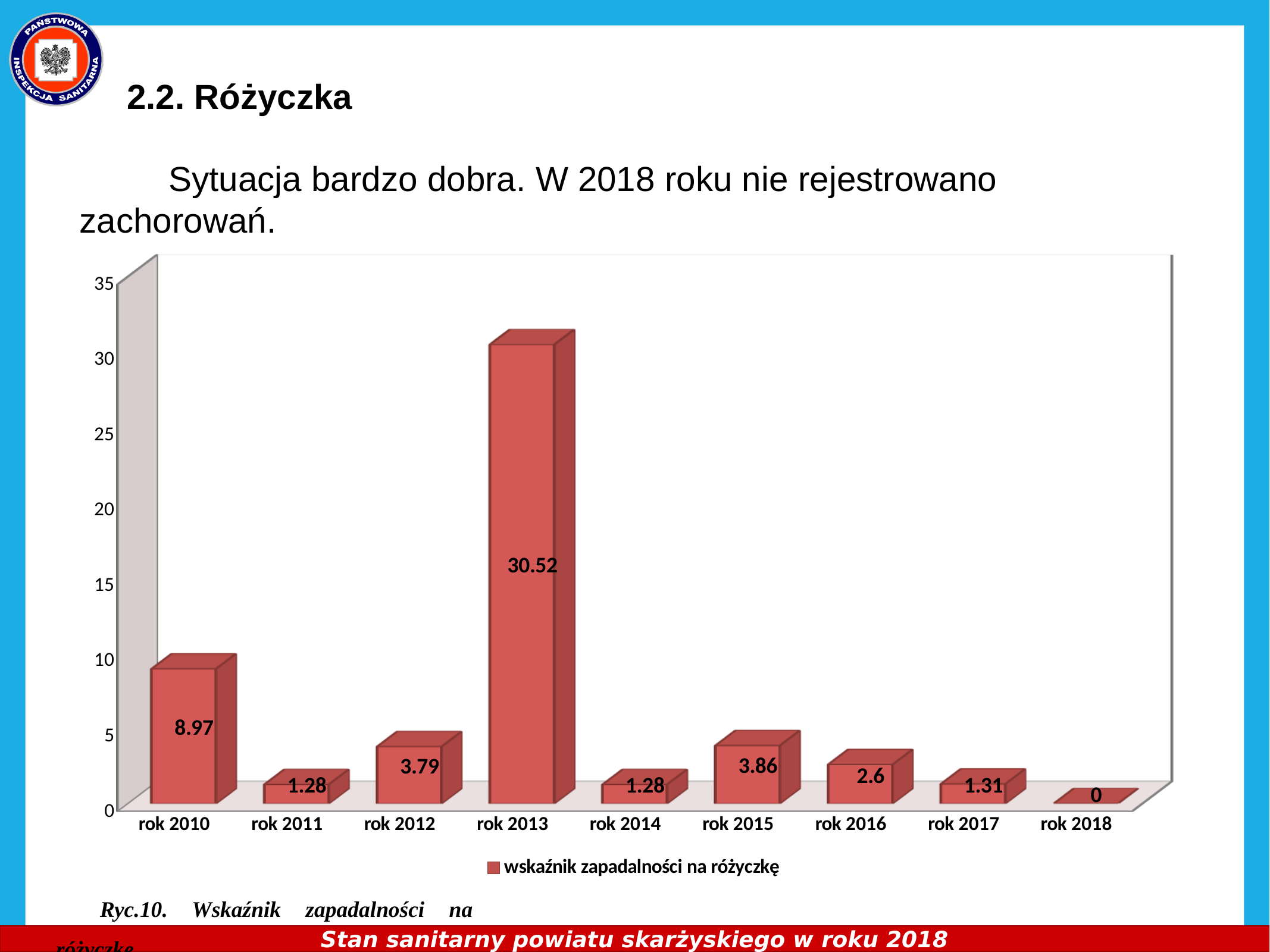
Is the value for rok 2013 greater or less than 30? greater What is the difference between the values for rok 2013 and rok 2010? 21.55 Which is larger, the value for rok 2012 or the value for rok 2015? rok 2015 What is the value for rok 2016? 2.6 Which year has the highest value? rok 2013 Which year has the lowest value? rok 2018 What is the legend entry of the series shown in the chart? wskaźnik zapadalności na różyczkę What is the value for rok 2018? 0 How many years are shown on the x axis? 9 What kind of chart is shown on the slide? bar chart What is the value for rok 2013? 30.52 What is the value for rok 2010? 8.97